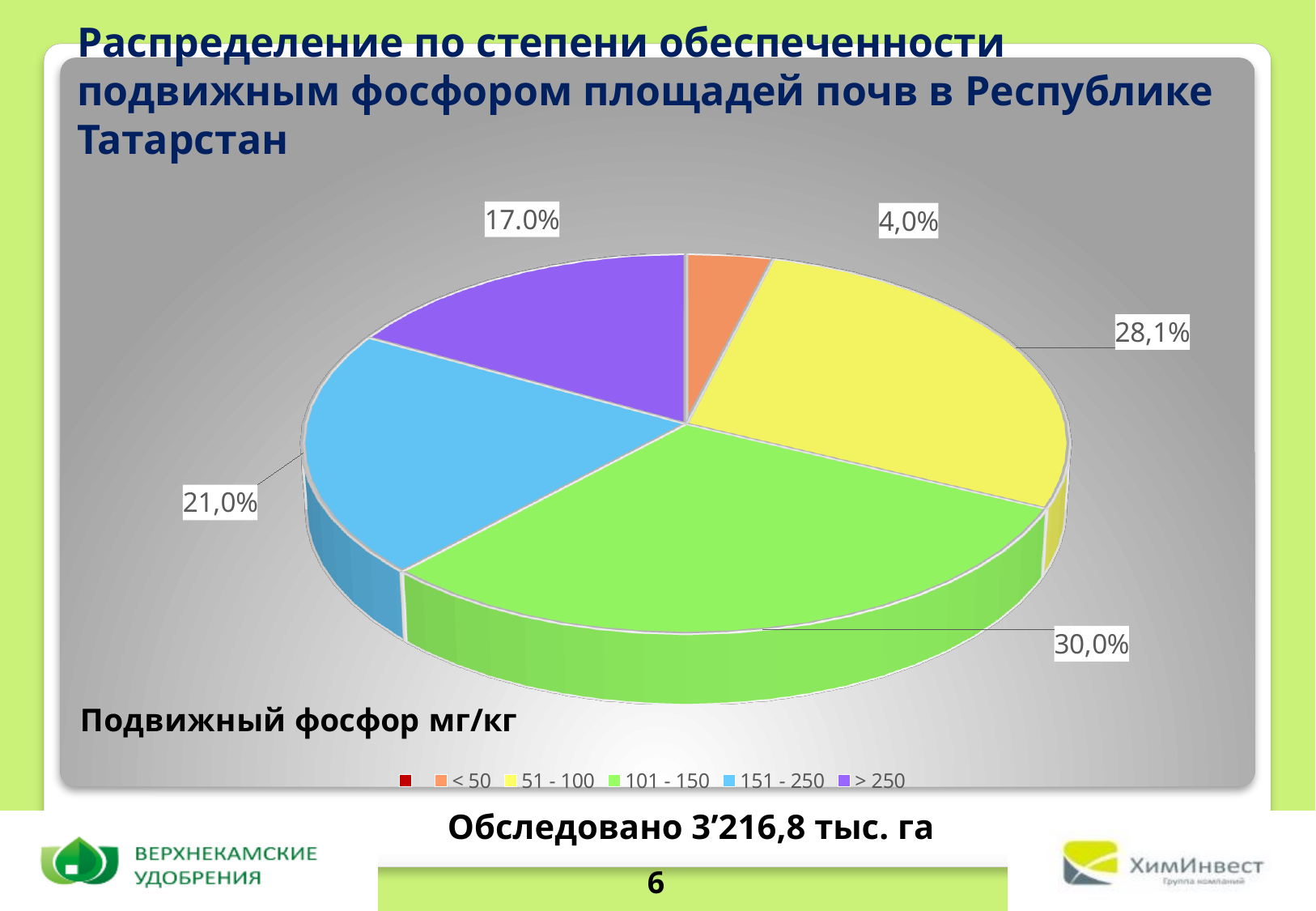
What share of the pie does the "< 50" category (orange slice) have? 4,0% Which slice is larger: "151 - 250" or "> 250"? 151 - 250 What share of the pie does the "151 - 250" category (blue slice) have? 21,0% What kind of chart is shown on the slide? pie chart Which category has the smallest slice of the pie? < 50 What is the difference in percentage points between the "101 - 150" slice and the "< 50" slice? 26,0% How many slices are shown in the pie chart? 5 Which category has the largest slice of the pie? 101 - 150 What share of the pie does the "51 - 100" category (yellow slice) have? 28,1% What colour is the slice for the "151 - 250" category? blue